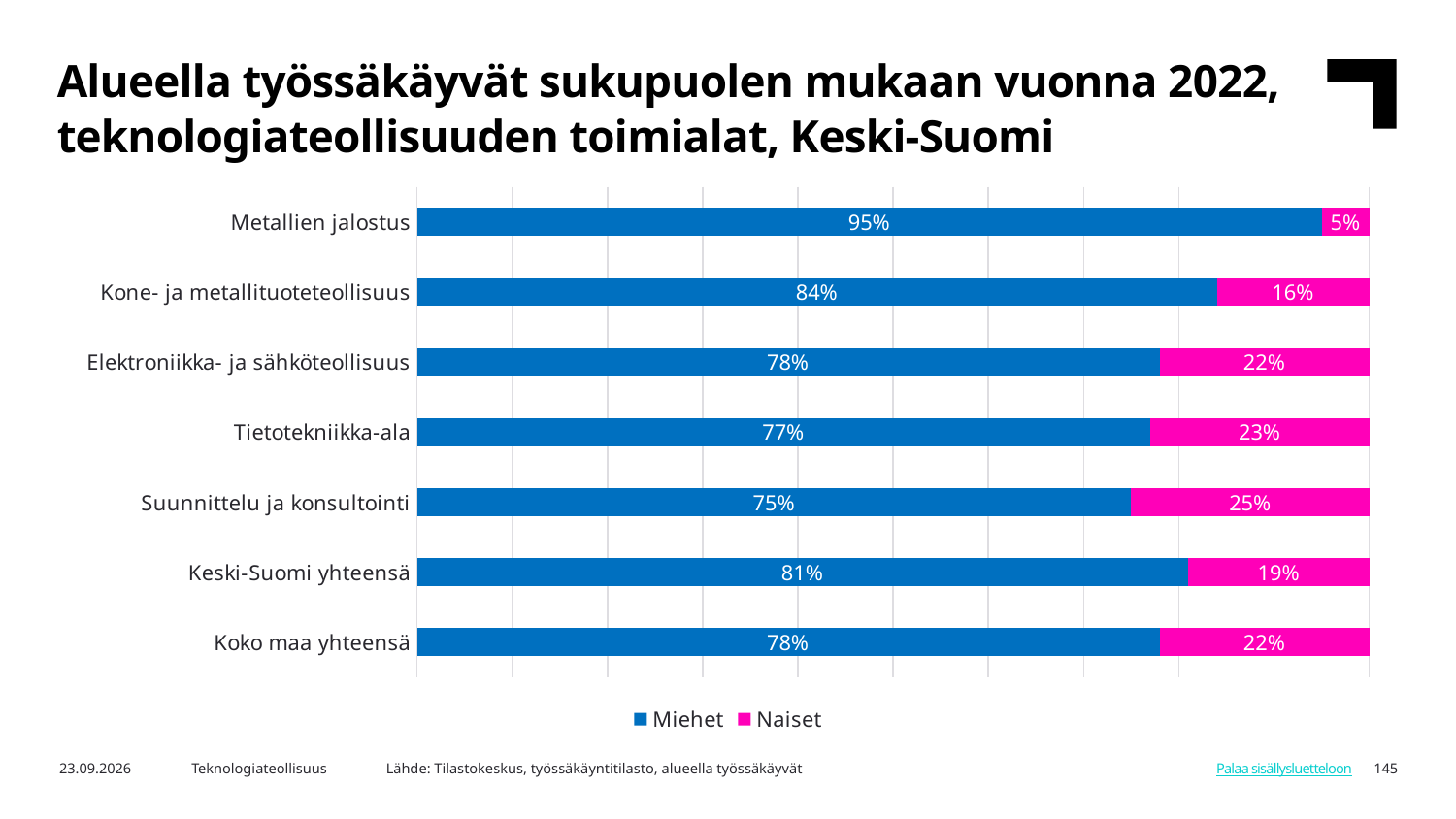
What is the total of the stacked bar for Koko maa yhteensä? 100% What is the Miehet share for Keski-Suomi yhteensä? 81% What is the Naiset share for Suunnittelu ja konsultointi? 25% Which category has the lowest Miehet share? Suunnittelu ja konsultointi Which is larger, the Naiset share for Elektroniikka- ja sähköteollisuus or for Kone- ja metallituoteteollisuus? Elektroniikka- ja sähköteollisuus Which category has the highest Miehet share? Metallien jalostus What is the Miehet share for Metallien jalostus? 95% How many categories are shown on the chart? 7 How many series does the legend list? 2 What is the Naiset share for Kone- ja metallituoteteollisuus? 16% What kind of chart is shown on the slide? Stacked bar chart What is the difference between the Naiset share for Tietotekniikka-ala and for Metallien jalostus? 18 percentage points